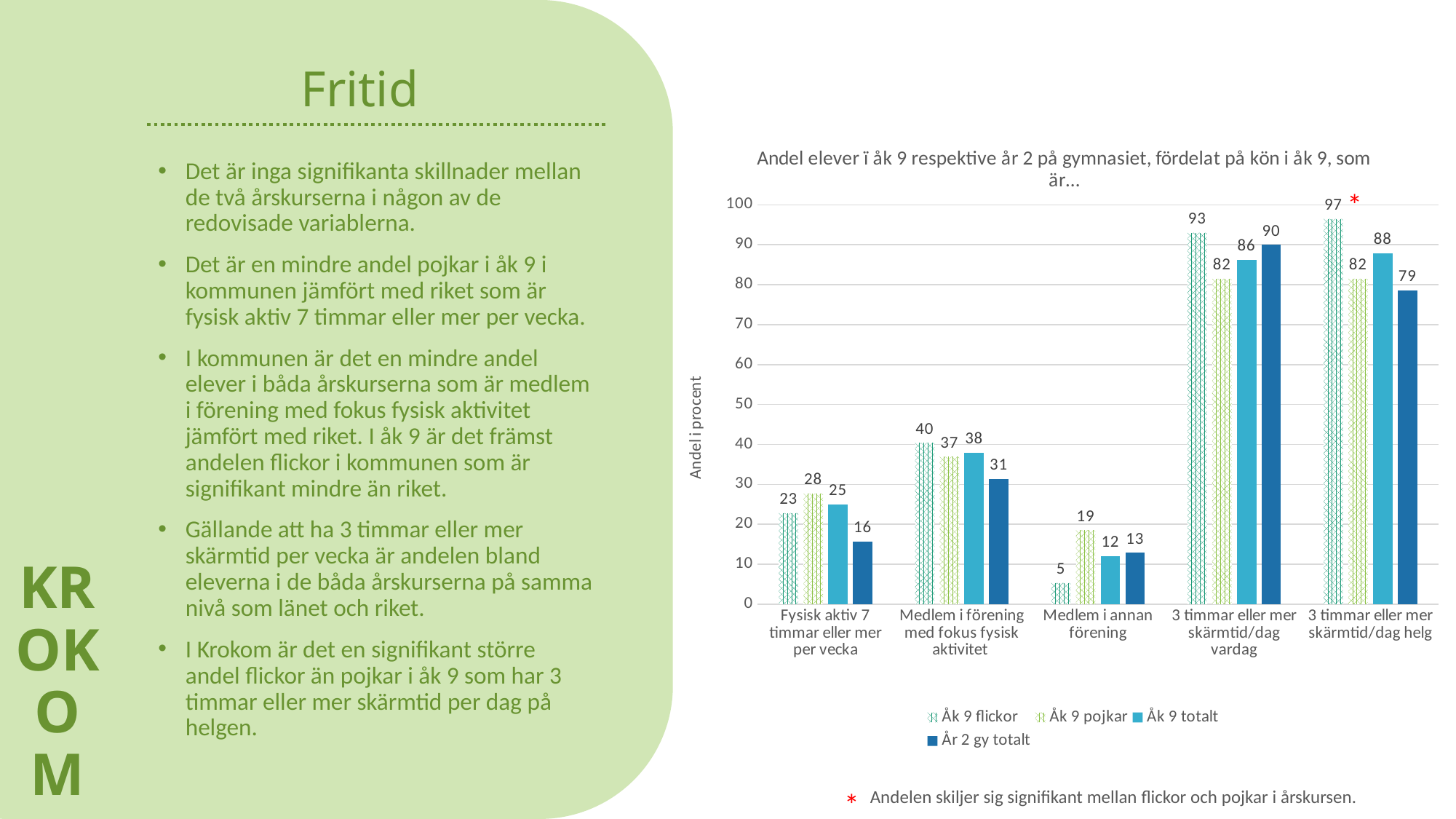
What does the red asterisk next to the bar in '3 timmar eller mer skärmtid/dag helg' indicate, according to the note below the chart? Andelen skiljer sig signifikant mellan flickor och pojkar i årskursen. How many series does the legend list? 4 What is the value for Åk 9 totalt in the category '3 timmar eller mer skärmtid/dag helg'? 88 What is the difference between Åk 9 flickor and Åk 9 pojkar in the category '3 timmar eller mer skärmtid/dag helg'? 15 What kind of chart is shown on the slide? Bar chart Which category has the highest value for Åk 9 flickor? 3 timmar eller mer skärmtid/dag helg What is the value for Åk 9 flickor in the category 'Medlem i annan förening'? 5 What is the value for År 2 gy totalt in the category 'Fysisk aktiv 7 timmar eller mer per vecka'? 16 In the category 'Medlem i annan förening', which is larger: Åk 9 pojkar or Åk 9 flickor? Åk 9 pojkar What is the label of the y axis? Andel i procent How many categories are shown on the x axis? 5 Which category has the lowest value for Åk 9 pojkar? Medlem i annan förening